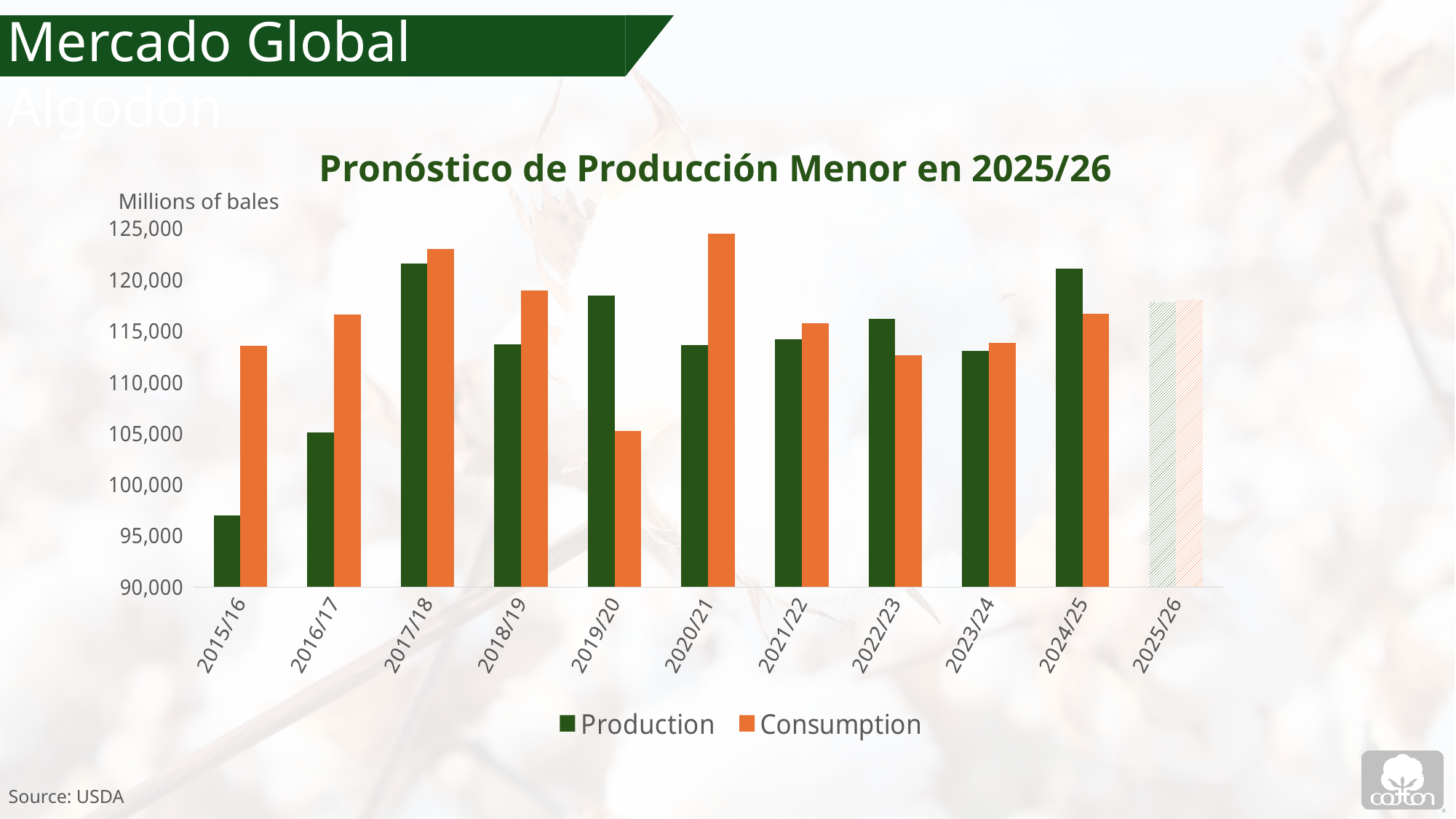
Does Production rise or fall from 2015/16 to 2017/18? Rise What kind of chart is shown on the slide? Bar chart Which season has the lowest Production value? 2015/16 Which season has the highest Consumption value? 2020/21 What unit is given for the y axis of the chart? Millions of bales In 2015/16, which is larger, Production or Consumption? Consumption Is the Consumption value for 2020/21 greater or less than 120,000? greater Which season has the lowest Consumption value? 2019/20 In 2019/20, which is larger, Production or Consumption? Production How many series does the legend list? 2 How many seasons (categories) are shown on the x axis? 11 Is the Production value for 2015/16 greater or less than 100,000? less